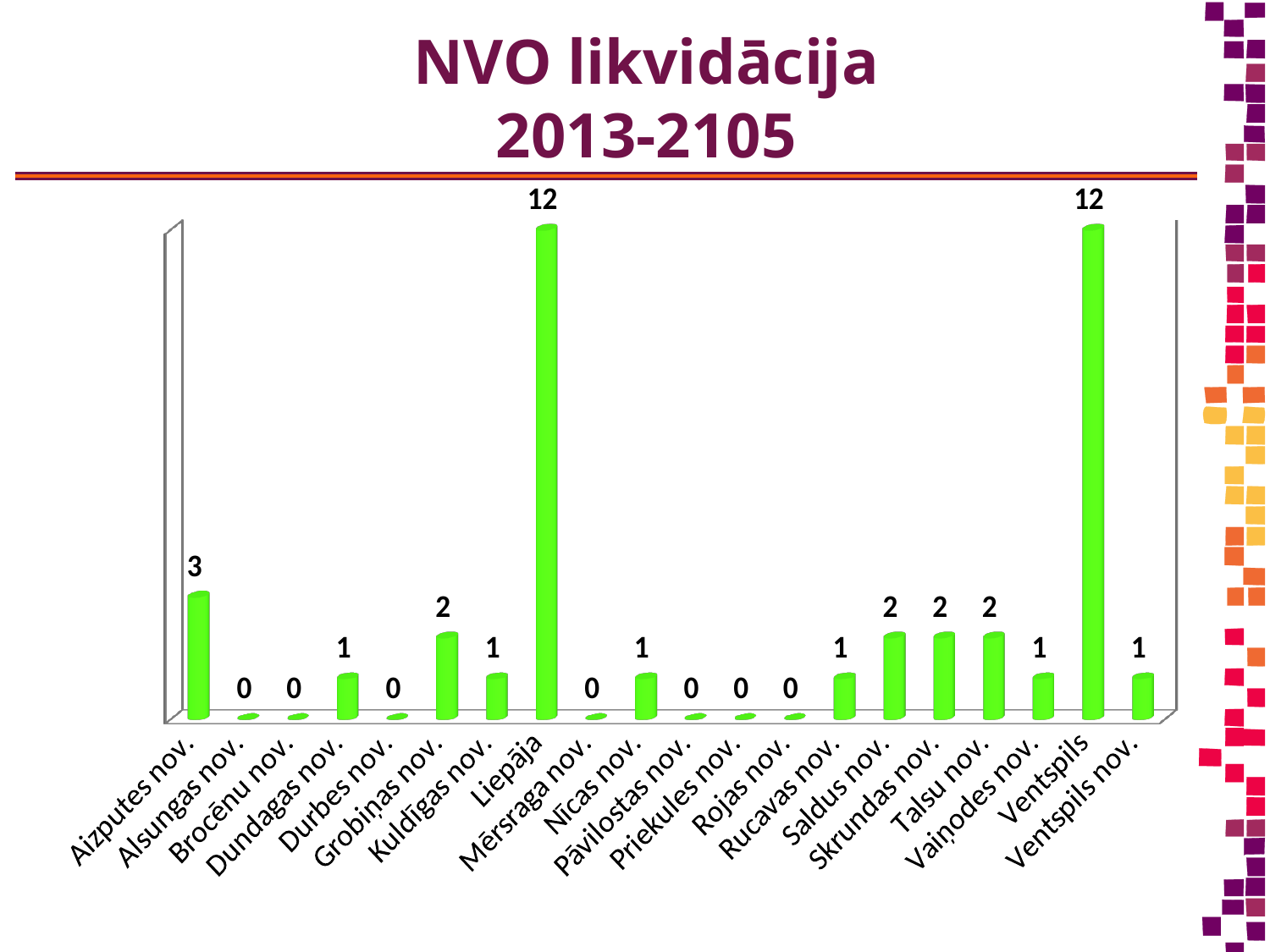
What is the value for Grobiņas nov.? 2 What is the value for Vaiņodes nov.? 1 Which is larger, the value for Aizputes nov. or the value for Talsu nov.? Aizputes nov. What kind of chart is shown on the slide? Bar chart What is the difference between the values for Saldus nov. and Kuldīgas nov.? 1 What is the value for Liepāja? 12 What is the value for Rojas nov.? 0 Which two categories share the highest value in the chart? Liepāja and Ventspils What is the difference between the values for Ventspils and Aizputes nov.? 9 How many categories are shown on the x axis? 20 What is the highest value shown in the chart? 12 What is the value for Aizputes nov.? 3